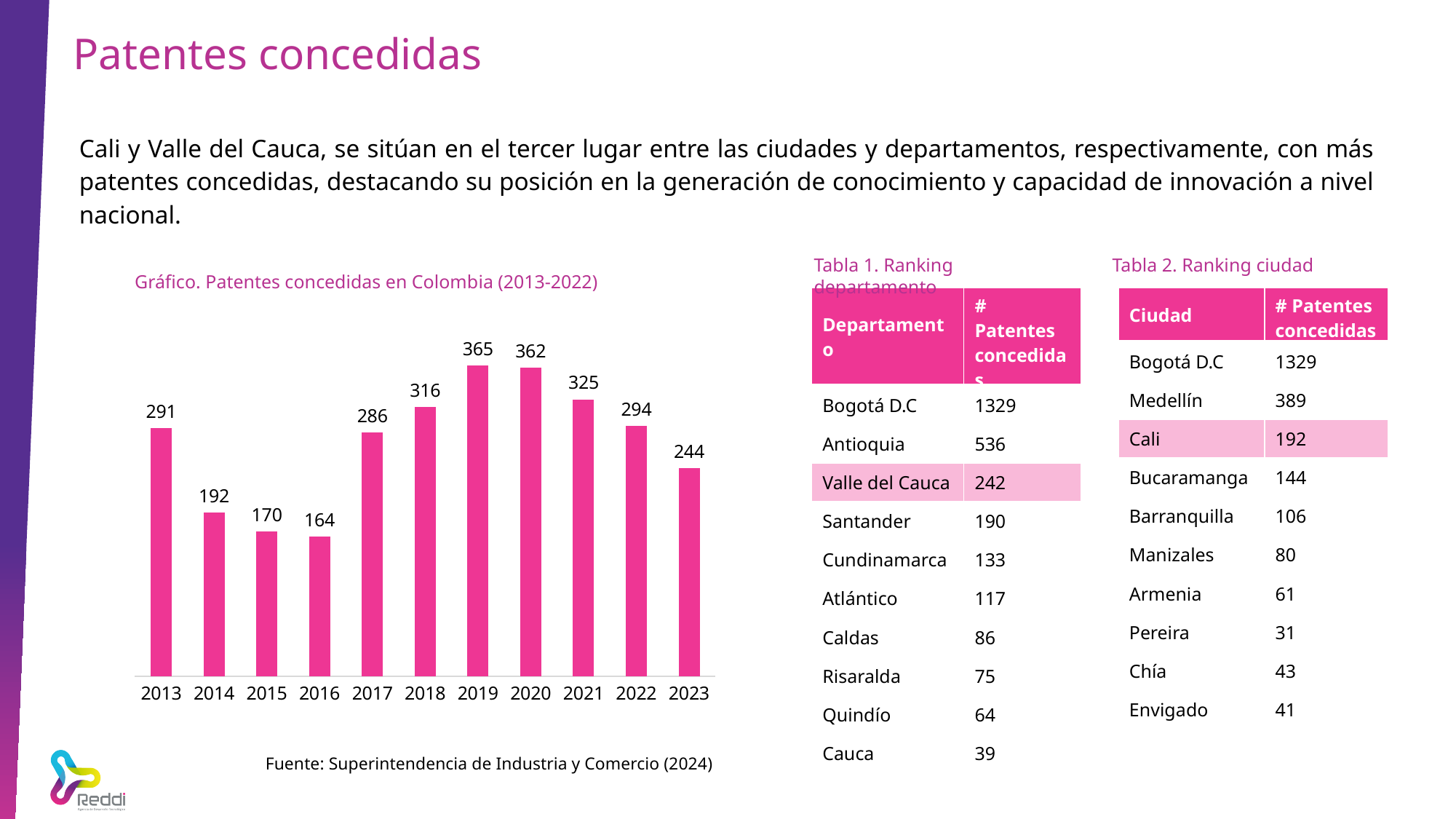
What is the difference between the values for 2022 and 2023 in the chart? 50 What kind of chart is shown on the slide? Bar chart What is the difference between the values for 2019 and 2013 in the chart? 74 Which year has the highest value in the chart? 2019 Which is larger in the chart, the value for 2017 or the value for 2018? 2018 What is the value for 2019 in the chart 'Patentes concedidas en Colombia (2013-2022)'? 365 Do the values in the chart rise or fall from 2013 to 2016? Fall What is the value for 2016 in the chart? 164 What is the title of the chart on the slide? Gráfico. Patentes concedidas en Colombia (2013-2022) Which year has the lowest value in the chart? 2016 What is the value for 2023 in the chart? 244 How many years are shown on the x axis of the chart? 11